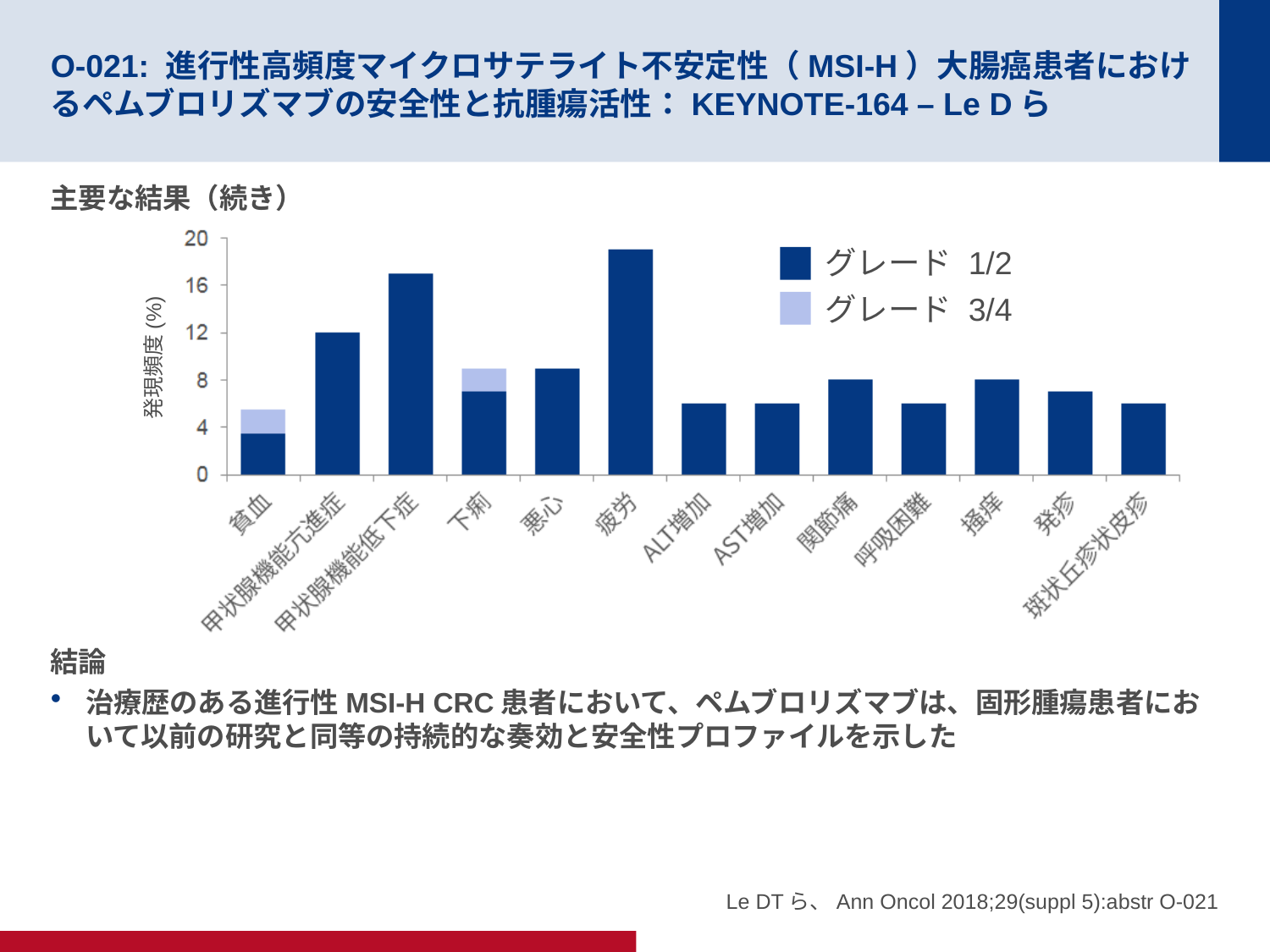
What is the value (%) for 甲状腺機能亢進症? 12 Is the total value for 貧血 greater or less than 8? less Which is larger, the bar for 甲状腺機能亢進症 or the bar for 下痢? 甲状腺機能亢進症 How many adverse event categories are shown on the x axis? 13 Is the value for 疲労 greater or less than 16? greater How many series does the legend list? 2 Which is larger, the bar for 疲労 or the bar for 甲状腺機能低下症? 疲労 Which categories include a グレード 3/4 segment? 貧血 and 下痢 Which category has the highest bar? 疲労 What is the value (%) for 関節痛? 8 Is the value for 甲状腺機能低下症 greater or less than 16? greater What kind of chart is shown on the slide? Bar chart